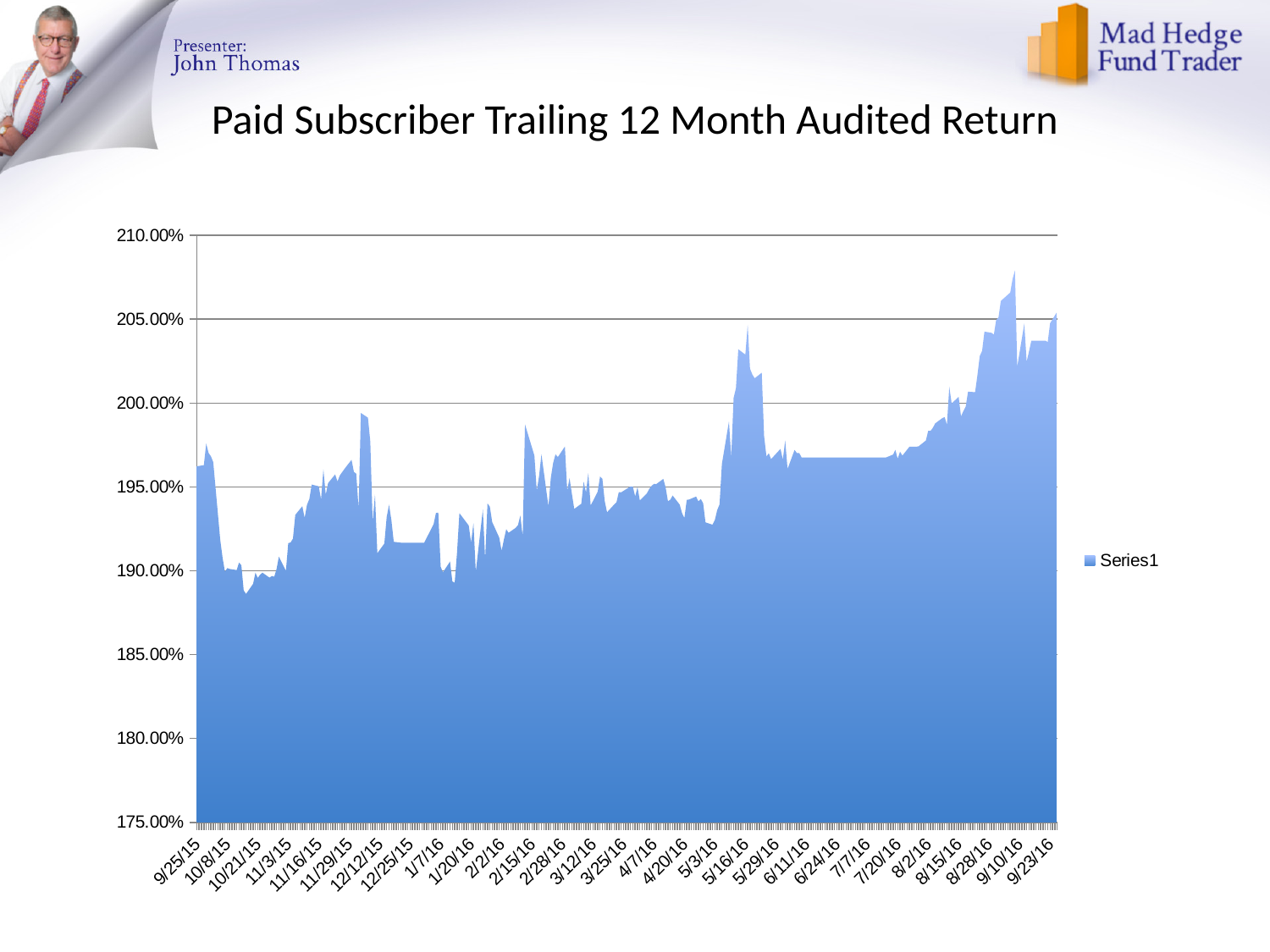
Does the value generally rise or fall from 6/24/16 to 9/23/16? rise Which is larger, the value for 9/25/15 or the value for 9/23/16? 9/23/16 What kind of chart is shown on the slide? Area chart How many series does the legend list? 1 Is the value for 4/7/16 greater or less than 200.00%? less What is the name of the series shown in the legend? Series1 Does the highest point of the chart occur near the start or near the end of the period? near the end Is the value for 1/7/16 greater or less than 195.00%? less Is the value for 6/24/16 greater or less than 200.00%? less What is the title of the chart? Paid Subscriber Trailing 12 Month Audited Return